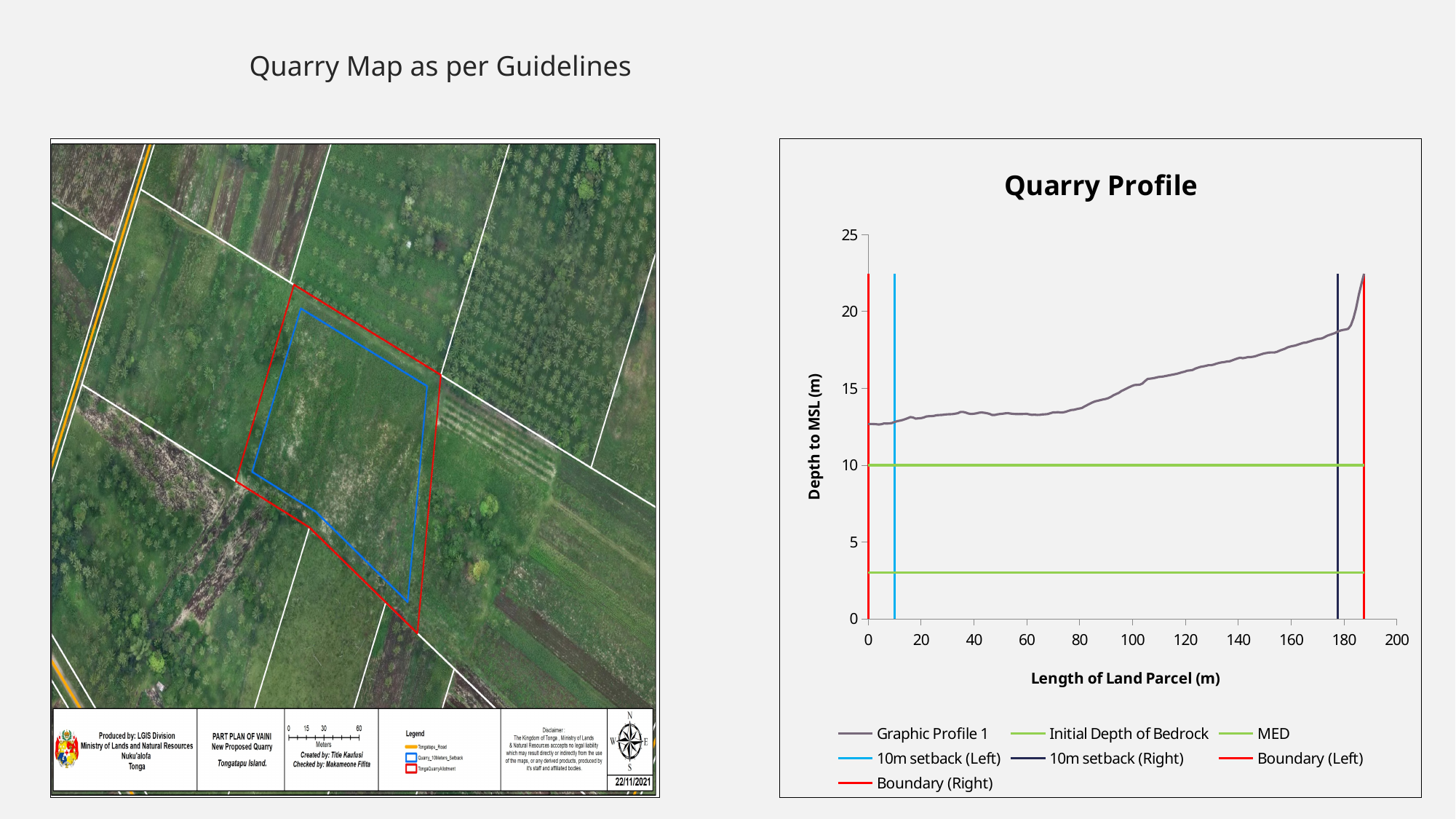
In the Quarry Profile chart, at what depth does the Initial Depth of Bedrock line sit? 10 In the Quarry Profile chart, is the Graphic Profile 1 value at 0 m greater or less than 10? greater How many series does the legend of the Quarry Profile chart list? 7 In the Quarry Profile chart, which line sits higher: Initial Depth of Bedrock or MED? Initial Depth of Bedrock What is the label of the x axis of the Quarry Profile chart? Length of Land Parcel (m) In the Quarry Profile chart, is the Graphic Profile 1 value at 160 m greater or less than 20? less What kind of chart is the Quarry Profile chart? line chart In the Quarry Profile chart, is the Graphic Profile 1 value at 0 m greater or less than 15? less In the Quarry Profile chart, does the Graphic Profile 1 line rise or fall as the length of the land parcel increases? rise What is the title of the chart on the right of the slide? Quarry Profile In the Quarry Profile chart, is the Graphic Profile 1 value larger at 0 m or at 180 m? 180 m